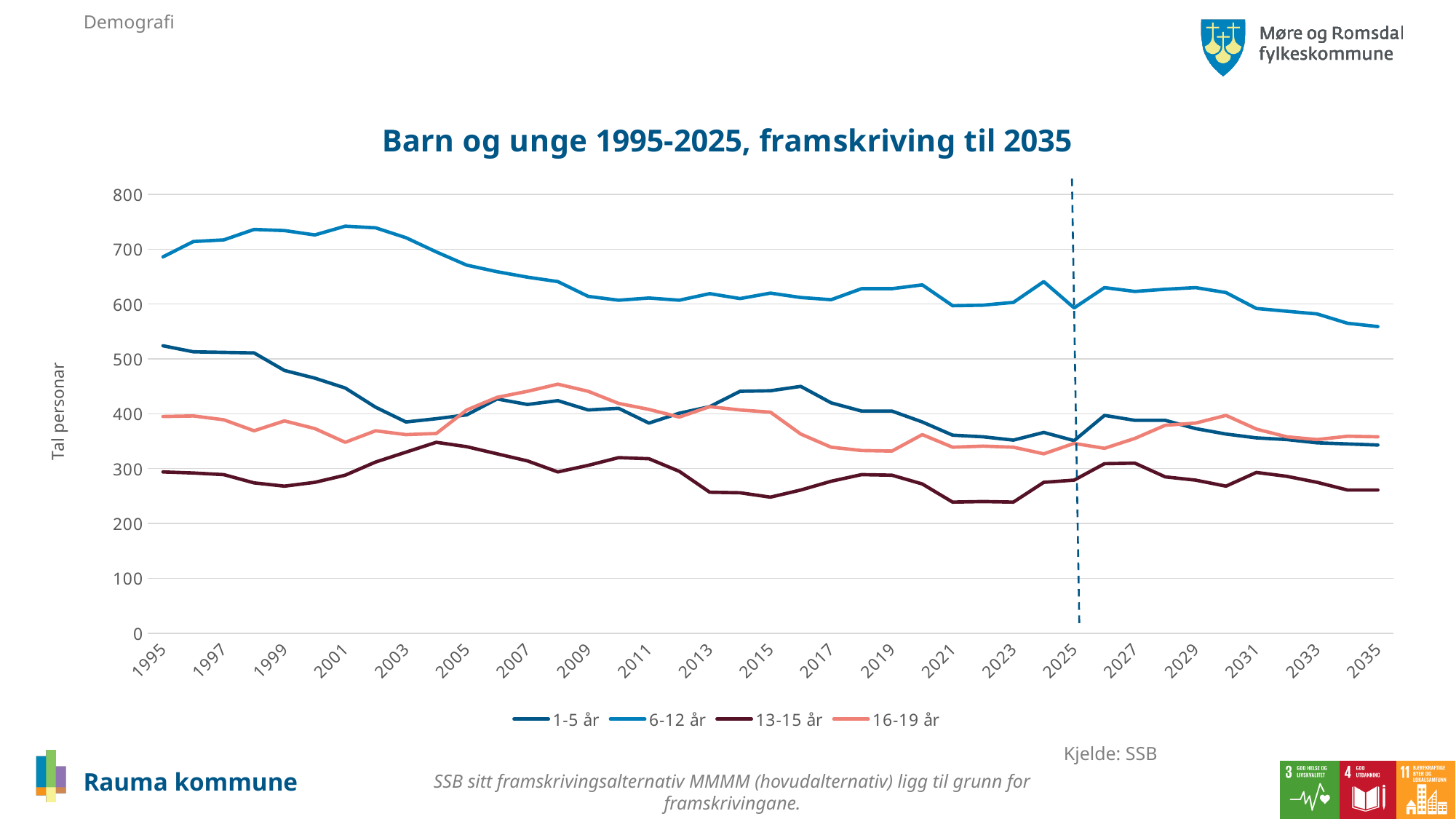
Does the value for 1-5 år rise or fall from 1995 to 2003? fall What is the title of the chart? Barn og unge 1995-2025, framskriving til 2035 Is the value for 6-12 år in 1995 greater or less than 600? greater Is the value for 1-5 år in 1995 greater or less than 500? greater How many series does the legend list? 4 In 2009, which is larger: the value for 16-19 år or the value for 1-5 år? 16-19 år What kind of chart is shown on the slide? line chart Which age group has the highest value in 2035? 6-12 år Which age group has the highest value in 1995? 6-12 år What is the label on the vertical axis? Tal personar Is the value for 13-15 år in 2021 greater or less than 300? less Which age group has the lowest value in 1995? 13-15 år